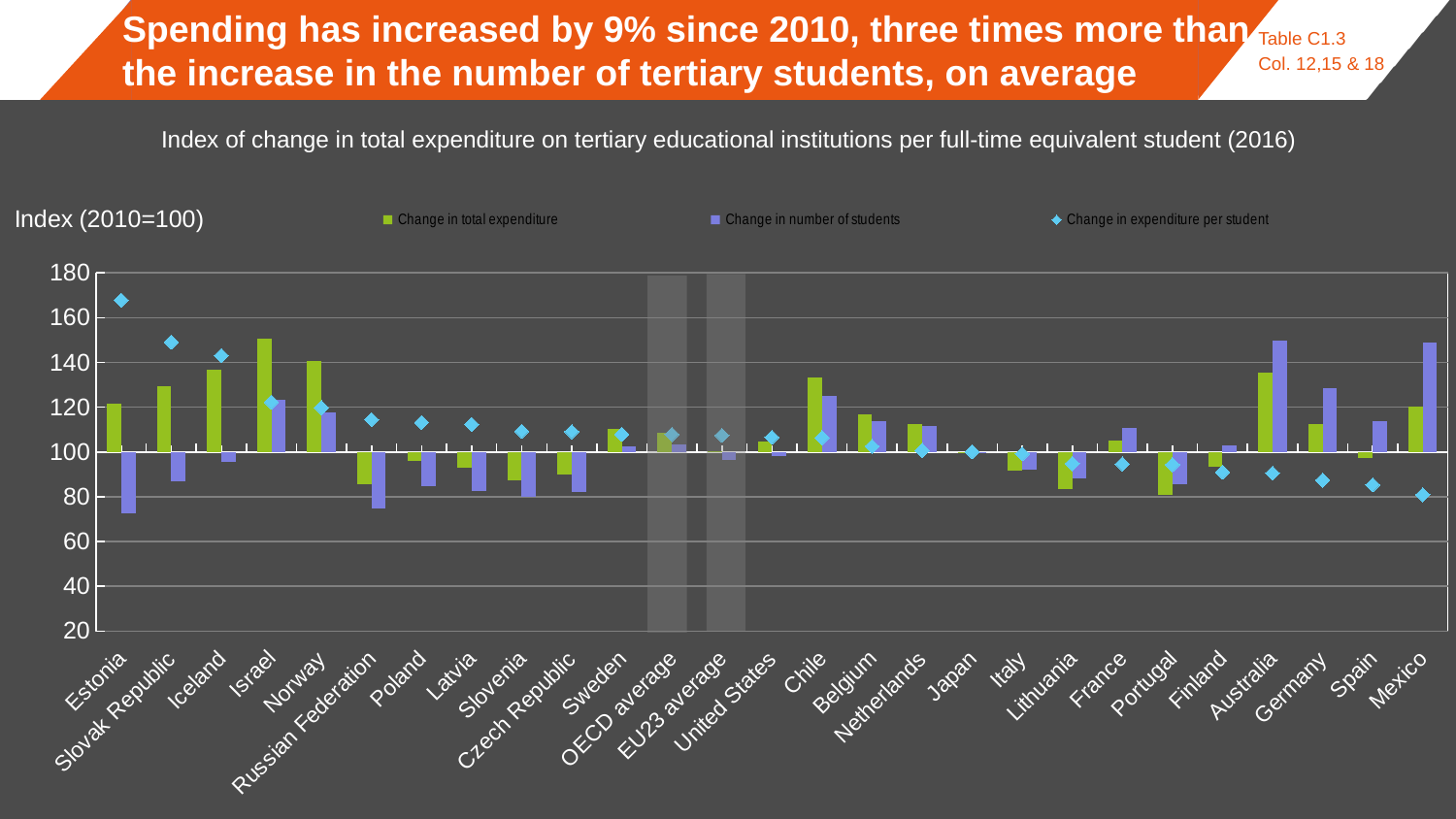
Is the change in number of students for Estonia greater or less than 80? less How many series does the legend list? 3 Is the change in number of students for the Russian Federation greater or less than 80? less Is the change in total expenditure for Chile greater or less than 120? greater Which country has the highest value for change in expenditure per student? Estonia How many countries or averages are shown on the x axis? 27 Which country has the highest value for change in total expenditure? Israel What kind of chart is shown on the slide? bar chart (with diamond markers) Which colour represents the change in number of students in the legend? purple Which is larger for Estonia: the change in total expenditure or the change in number of students? change in total expenditure